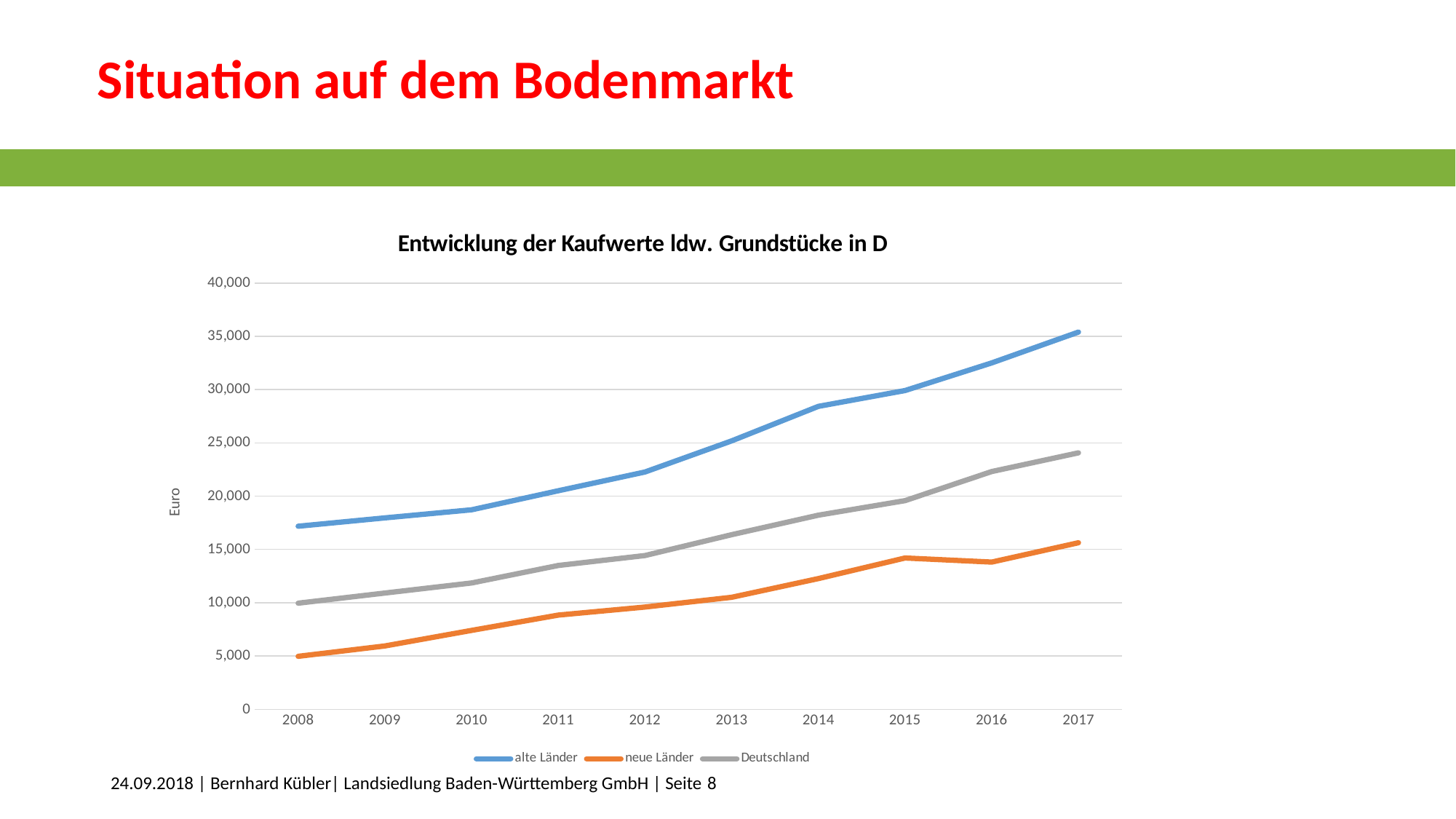
Is the value for alte Länder in 2017 greater or less than 30,000? greater What is the label on the y axis? Euro Does the alte Länder line rise or fall from 2008 to 2017? rise How many series does the legend list? 3 Is the value for Deutschland in 2017 greater or less than 25,000? less Which series has the lowest value in 2008? neue Länder How many years are shown on the x axis? 10 What kind of chart is shown on the slide? line chart Which series has the highest value in 2017? alte Länder Is the value for alte Länder in 2014 greater or less than 25,000? greater Which is larger in 2017, the value for Deutschland or the value for neue Länder? Deutschland